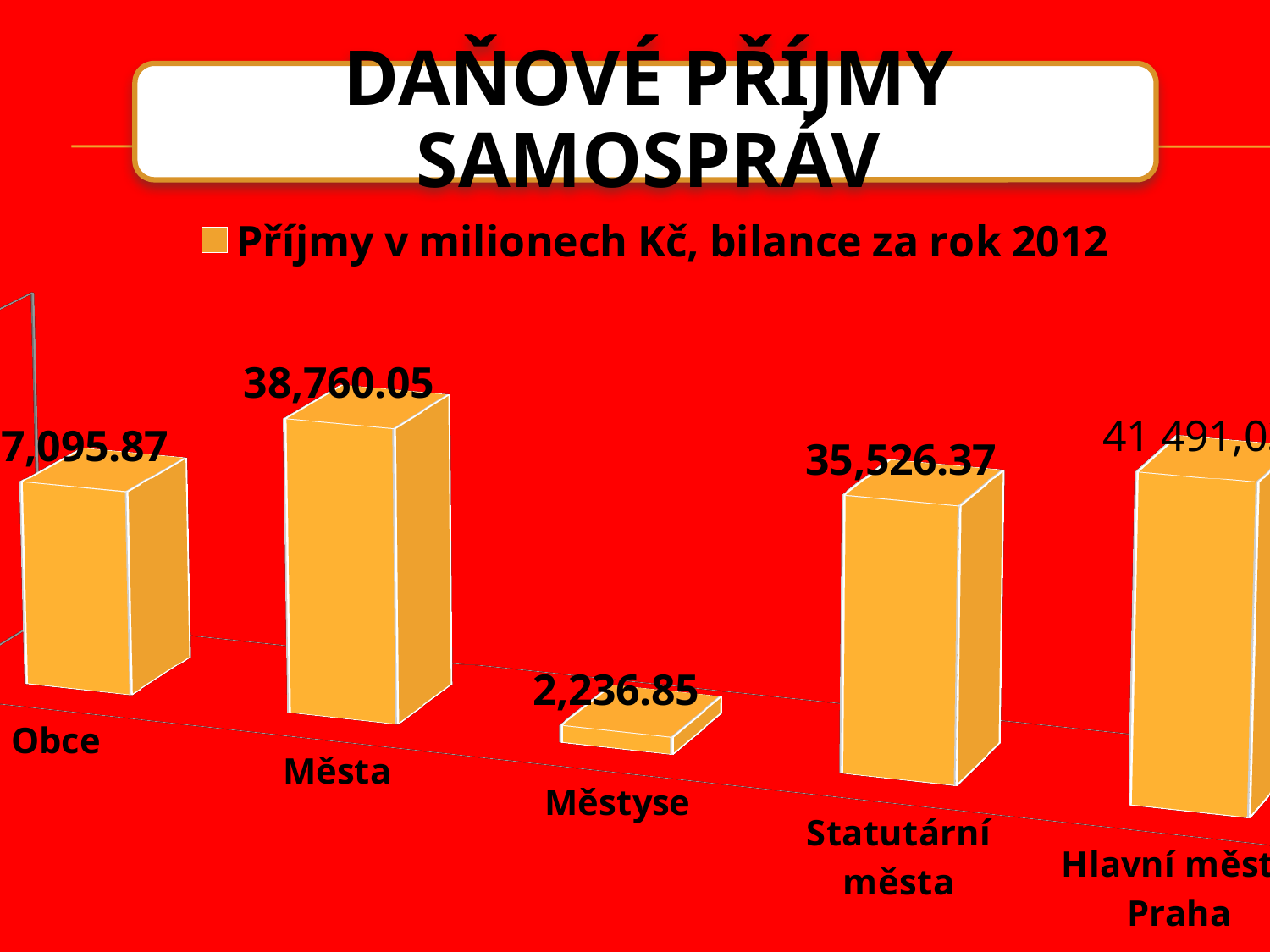
What kind of chart is shown on the slide? Bar chart What is the value for Města? 38,760.05 Which category has the lowest value? Městyse What is the value for Městyse? 2,236.85 What is the difference between the values for Města and Statutární města? 3,233.68 Which is larger, the value for Města or for Statutární města? Města What is the value for Statutární města? 35,526.37 How many series does the legend list? 1 What is the legend entry of the chart? Příjmy v milionech Kč, bilance za rok 2012 What is the difference between the values for Města and Městyse? 36,523.20 How many categories are shown on the chart? 5 Which is larger, the value for Městyse or for Statutární města? Statutární města